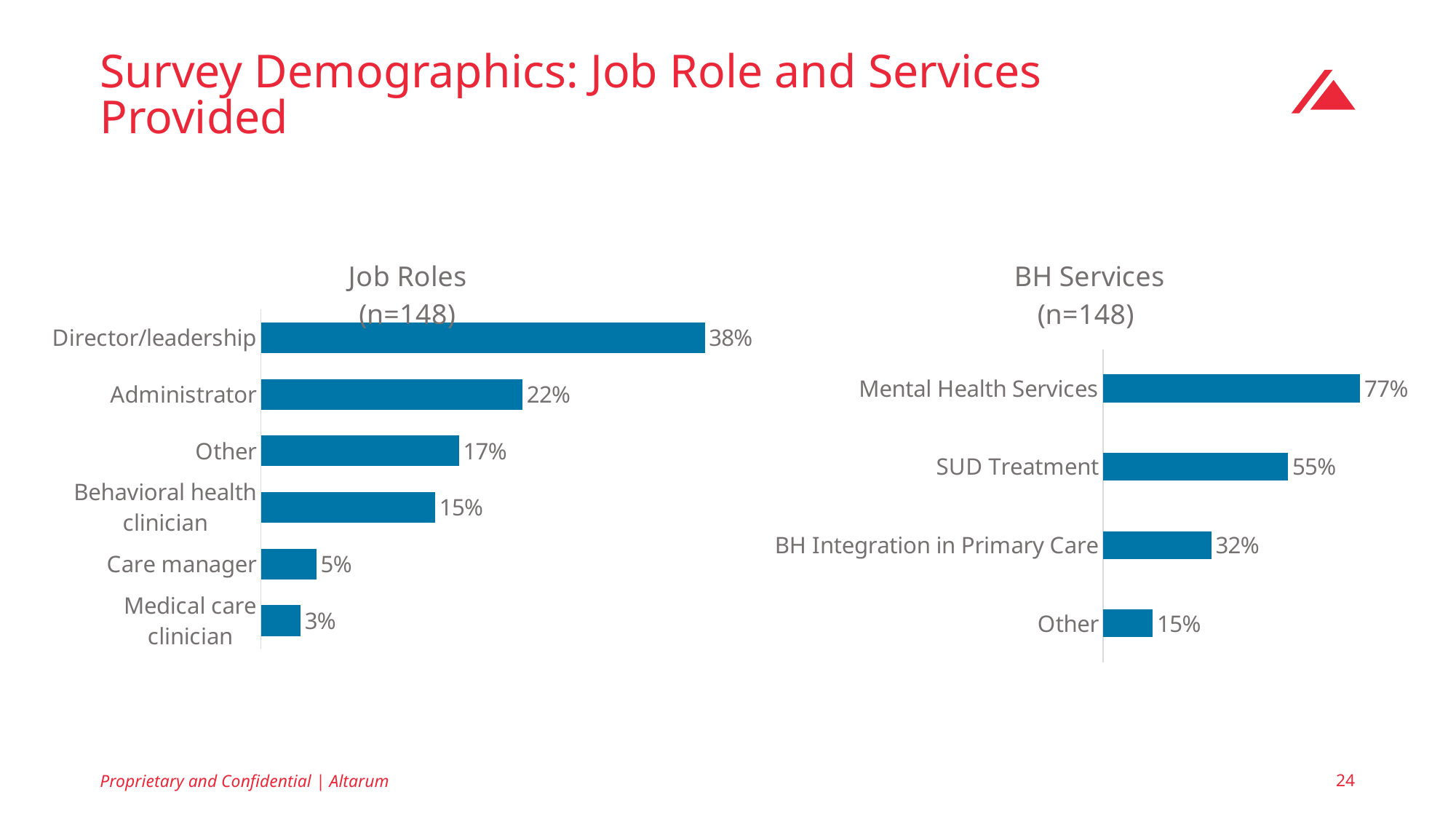
How many categories are shown in the BH Services chart? 4 What type of chart is the BH Services chart? Bar chart How many categories are shown in the Job Roles chart? 6 In the BH Services chart, what percentage is shown for SUD Treatment? 55% In the BH Services chart, which service has the highest percentage? Mental Health Services In the Job Roles chart, which job role has the lowest percentage? Medical care clinician In the Job Roles chart, which job role has the highest percentage? Director/leadership In the Job Roles chart, which is larger: Other or Behavioral health clinician? Other In the Job Roles chart, what percentage is shown for Administrator? 22% What sample size (n) is stated in the title of the Job Roles chart? n=148 In the Job Roles chart, what is the difference in percentage points between Director/leadership and Administrator? 16 In the BH Services chart, what is the difference in percentage points between Mental Health Services and SUD Treatment? 22